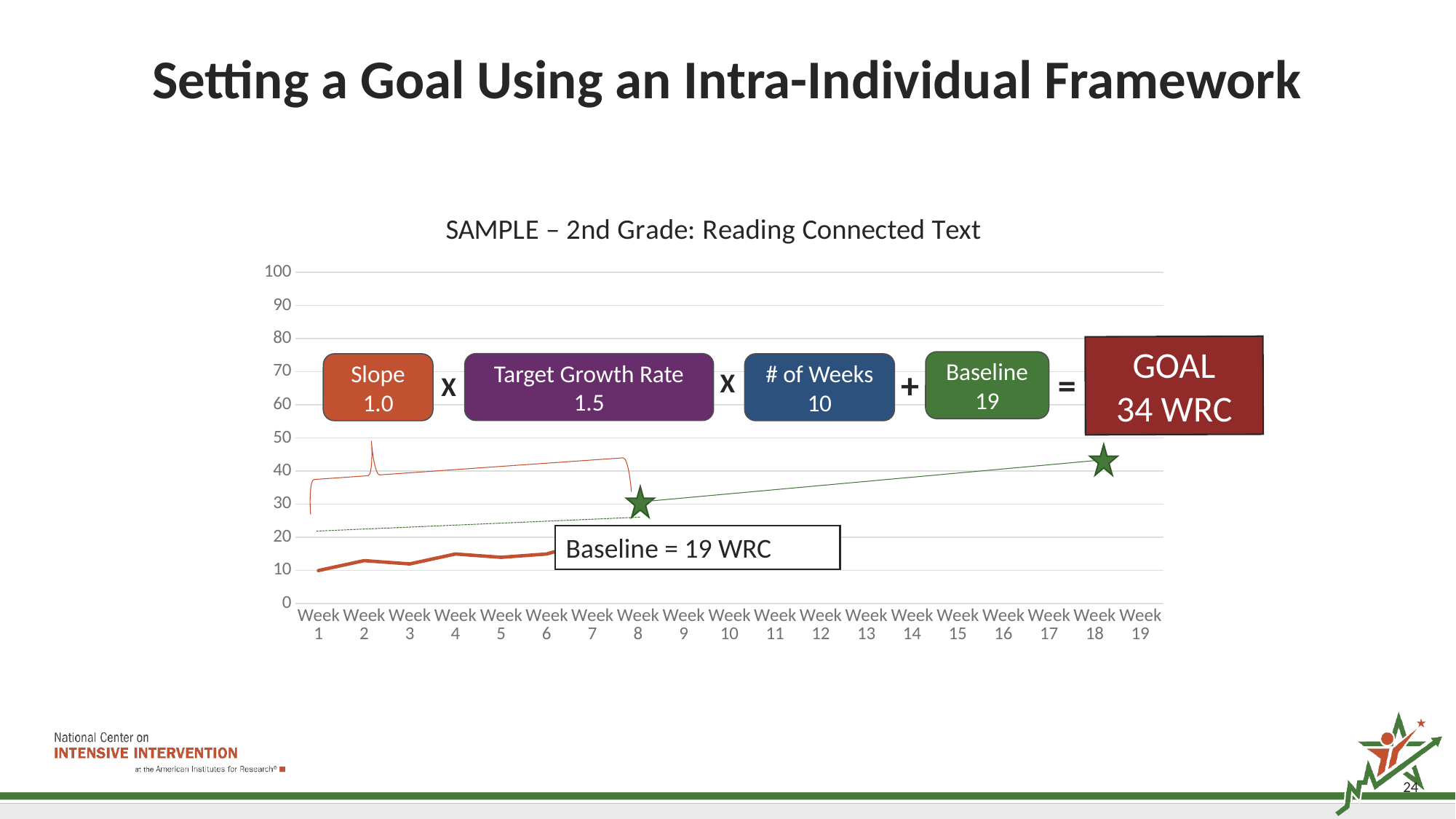
Is the value for Week 4 greater or less than 20? less What kind of chart is shown on the slide? line chart What baseline value is stated in the annotation box on the chart? Baseline = 19 WRC What is the title of the chart? SAMPLE – 2nd Grade: Reading Connected Text Is the value at the Week 8 star on the goal line greater or less than 40? less Is the value for Week 2 greater or less than 10? greater Does the green goal line rise or fall from Week 8 to Week 18? rise Which of Week 1 and Week 2 has the larger value? Week 2 How many weeks are labelled along the x axis of the chart? 19 What is the highest value shown on the y axis of the chart? 100